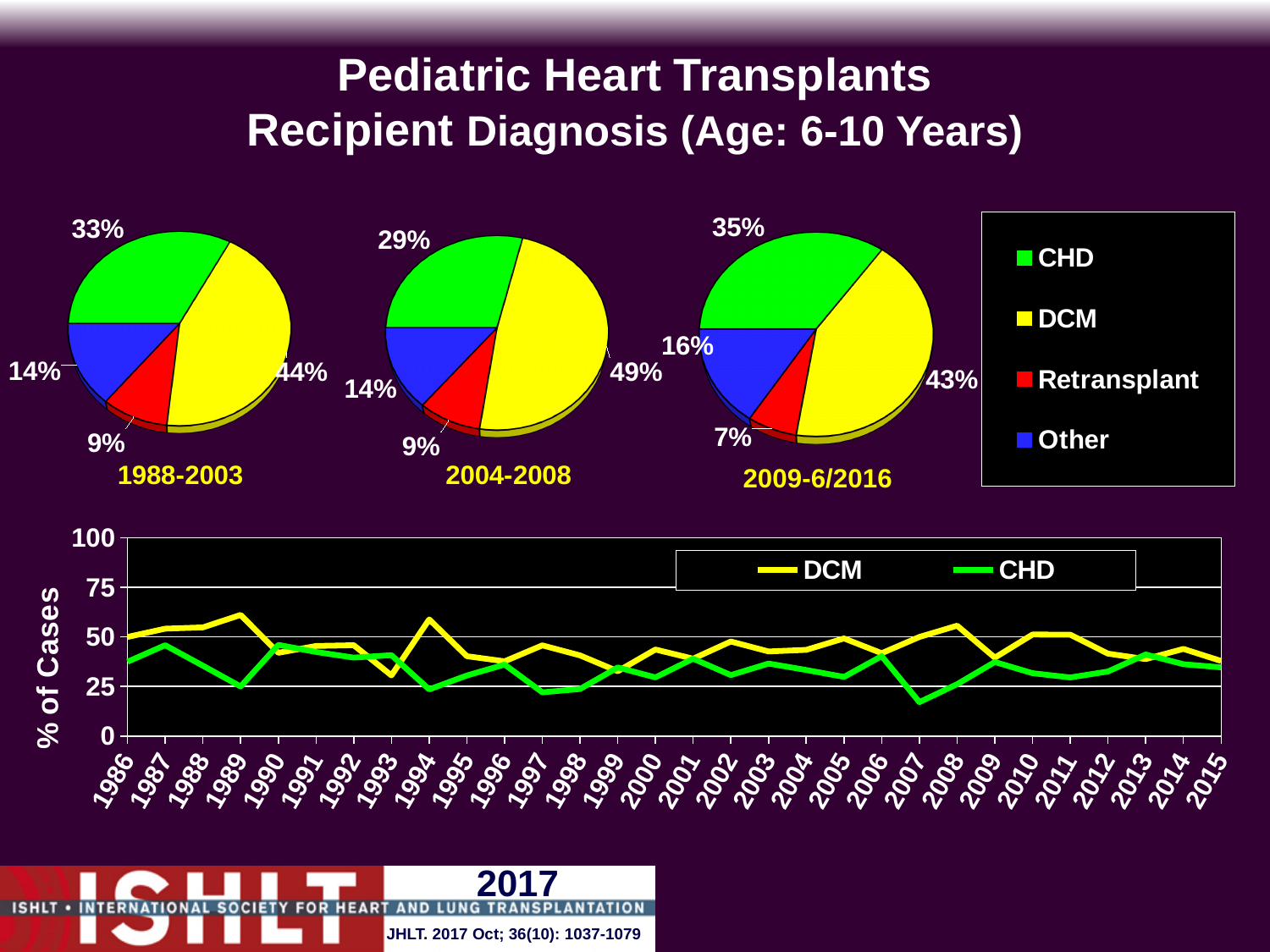
In the line chart at the bottom, how many series does the legend list? 2 In the 1988-2003 pie chart, which diagnosis has the smallest share? Retransplant In the 2004-2008 pie chart, what percentage of cases is CHD? 29% In the 1988-2003 pie chart, what percentage of cases is DCM? 44% In the 2004-2008 pie chart, what is the difference in percentage points between DCM and CHD? 20 In the line chart at the bottom, is the DCM value for 1989 greater or less than 50? greater In the 2009-6/2016 pie chart, which is larger, the Other share or the Retransplant share? Other In the 2009-6/2016 pie chart, which diagnosis has the largest share? DCM How many diagnosis categories does the pie chart legend list? 4 In the line chart at the bottom, is the CHD value for 2007 greater or less than 25? less What kind of chart is the chart at the bottom of the slide showing % of Cases by year? Line chart In the 2009-6/2016 pie chart, what percentage of cases is Retransplant? 7%